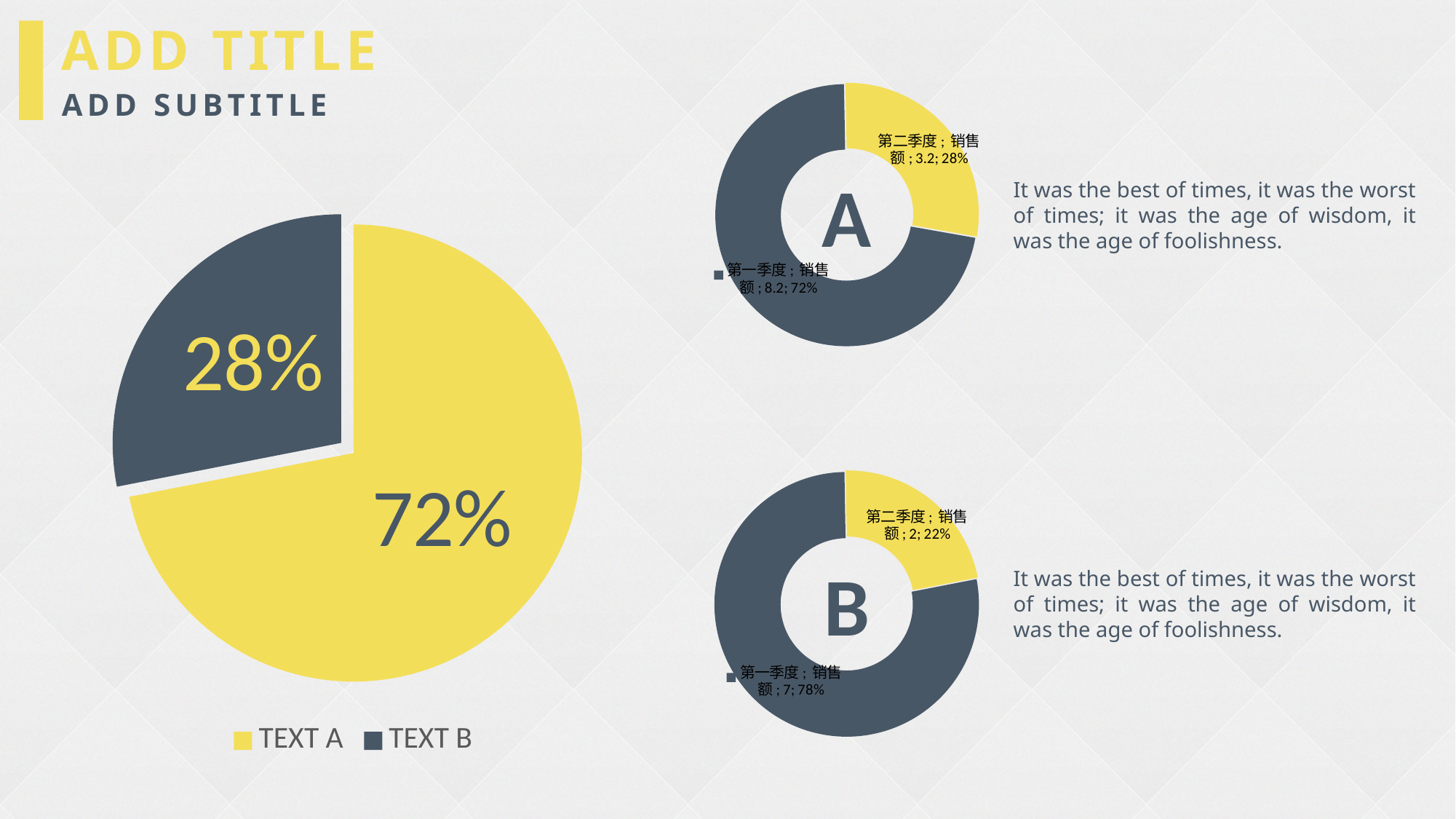
In the donut chart labelled A, what is the sales value (销售额) for 第二季度? 3.2 In the large pie chart on the left, what percentage is shown for TEXT B? 28% In the donut chart labelled A, what percentage share does 第一季度 have? 72% In the donut chart labelled B, what percentage share does 第二季度 have? 22% In the donut chart labelled B, which quarter has the smaller share? 第二季度 In the donut chart labelled B, what is the sales value (销售额) for 第一季度? 7 In the large pie chart on the left, what percentage is shown for TEXT A? 72% In the large pie chart on the left, which category has the larger share? TEXT A How many entries does the legend of the large pie chart on the left list? 2 In the donut chart labelled A, what is the difference between the sales values of 第一季度 and 第二季度? 5 In the large pie chart on the left, what is the difference in percentage points between TEXT A and TEXT B? 44 What kind of chart is the large chart on the left of the slide? Pie chart